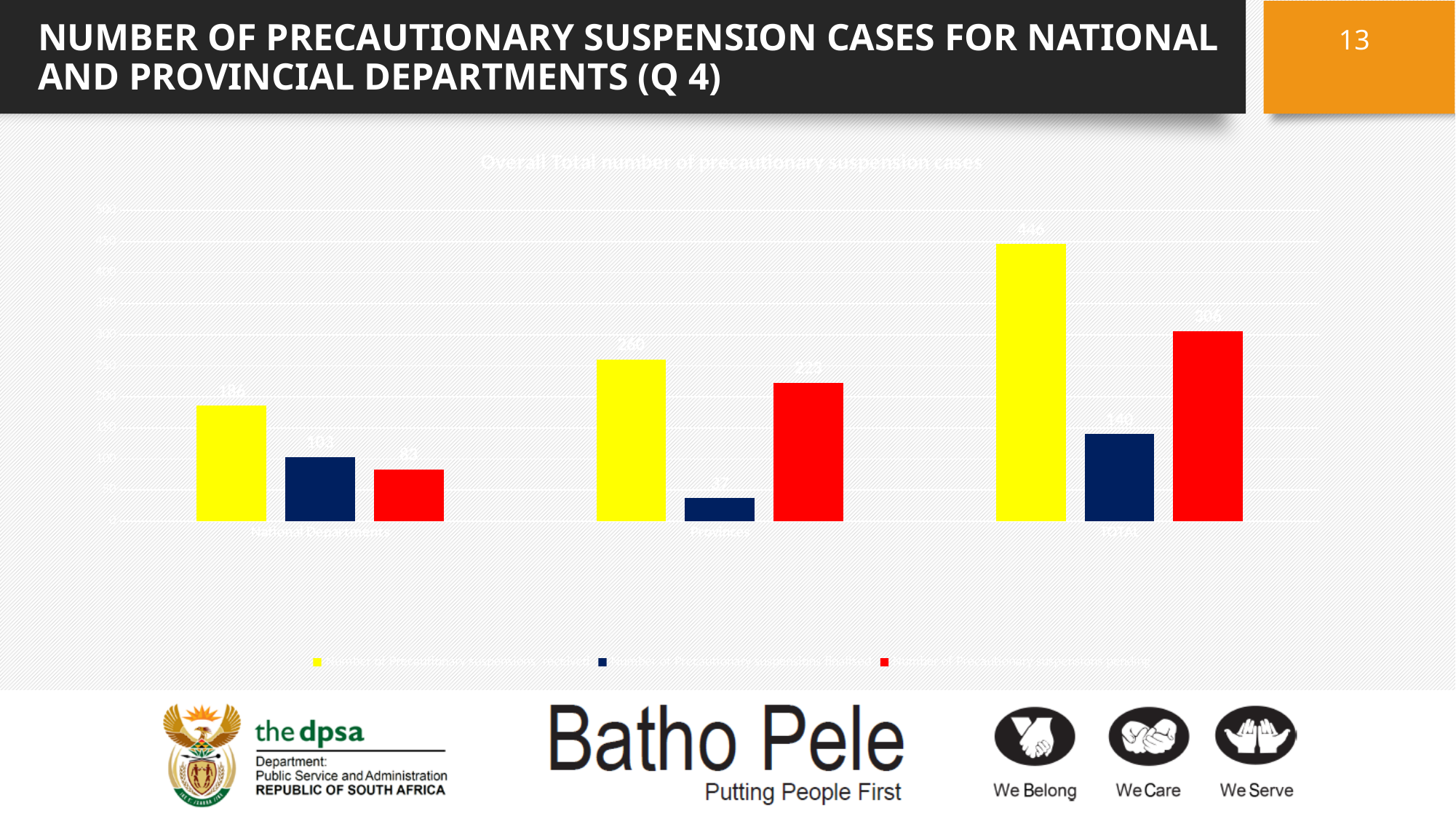
What kind of chart is shown on the slide? bar chart Which category has the lowest dark blue bar? Provinces What is the value of the dark blue bar for Provinces? 37 What colour is the tallest bar on the chart? yellow What is the value of the yellow bar for TOTAL? 446 What is the value of the red bar for Provinces? 223 What is the value of the yellow bar for National Departments? 186 For Provinces, which is larger: the yellow bar or the red bar? the yellow bar How many categories are shown along the x axis? 3 What is the difference between the yellow bar and the red bar for National Departments? 103 How many series does the legend list? 3 Which category has the tallest yellow bar? TOTAL